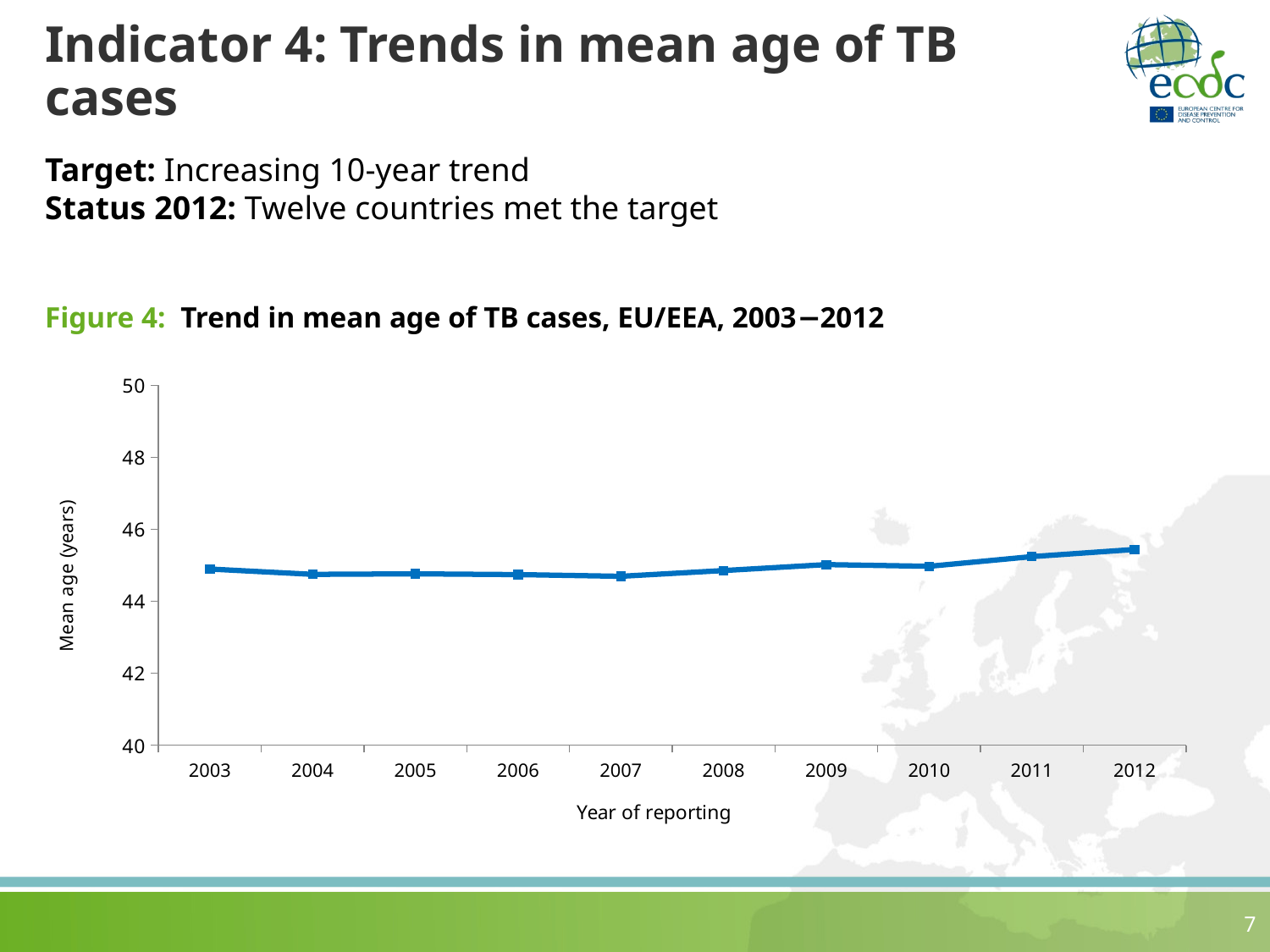
What kind of chart is shown in Figure 4? line chart What is the title of Figure 4? Trend in mean age of TB cases, EU/EEA, 2003−2012 Does the mean age of TB cases rise or fall between 2007 and 2012? rise Which is larger, the mean age of TB cases in 2007 or in 2011? 2011 Is the mean age of TB cases in 2003 greater or less than 46? less Is the mean age of TB cases in 2007 greater or less than 44? greater Which year has the highest mean age of TB cases on the chart? 2012 Is the mean age of TB cases in 2012 greater or less than 46? less Which is larger, the mean age of TB cases in 2003 or in 2012? 2012 How many years (data points) are plotted on the chart? 10 What is the label of the y-axis on the chart? Mean age (years)